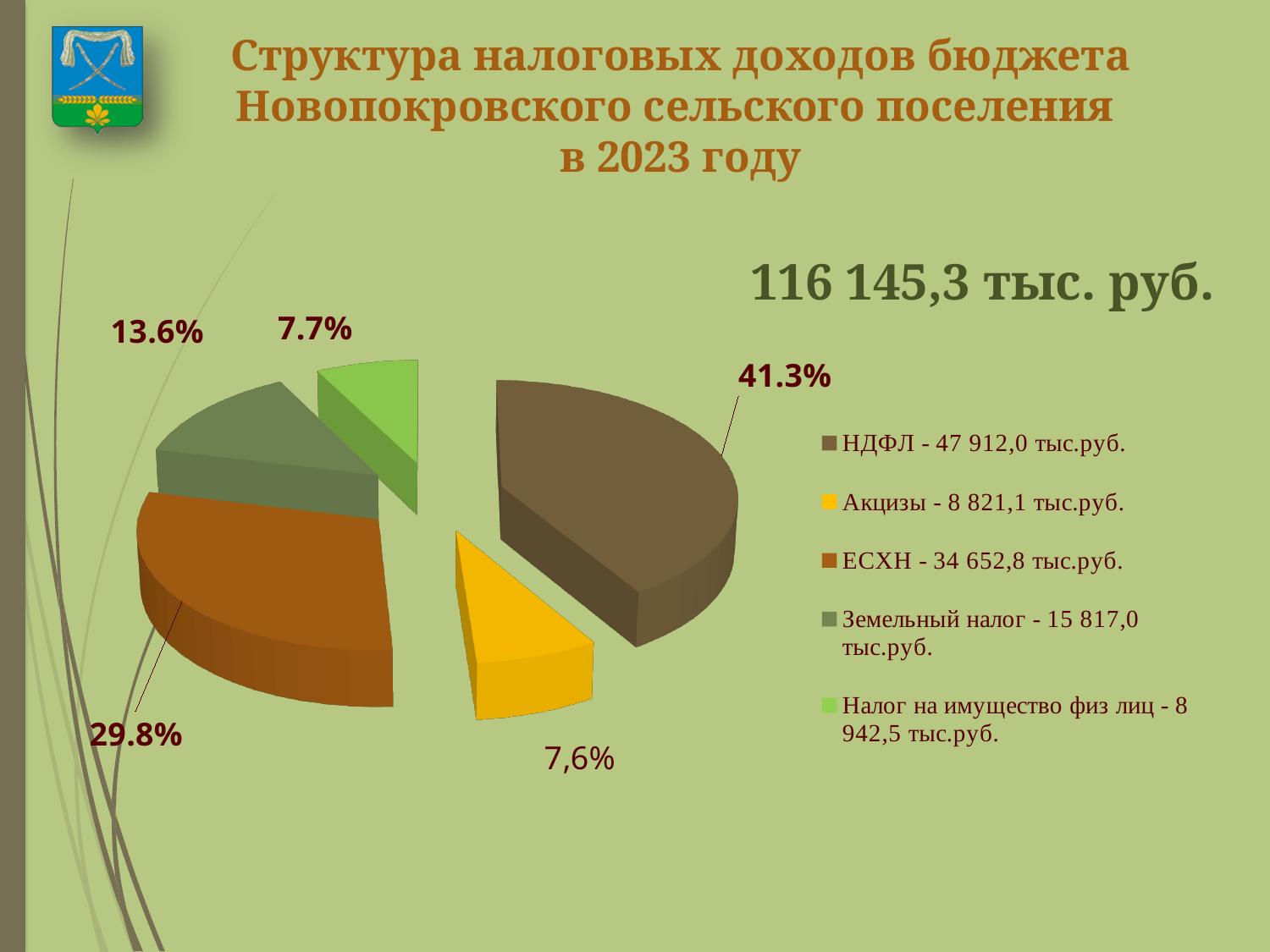
What share of the pie does НДФЛ take? 41.3% Which category has the largest slice of the pie? НДФЛ How many slices does the pie chart have? 5 What is the value for ЕСХН according to the legend? 34 652,8 тыс.руб. What is the value for НДФЛ according to the legend? 47 912,0 тыс.руб. How many entries does the legend list? 5 What kind of chart is shown on the slide? Pie chart What total amount of tax revenue is shown on the slide? 116 145,3 тыс. руб. Which category has the smallest slice of the pie? Акцизы What is the value for Земельный налог according to the legend? 15 817,0 тыс.руб. What share of the pie does ЕСХН take? 29.8% Which is larger, НДФЛ or ЕСХН? НДФЛ